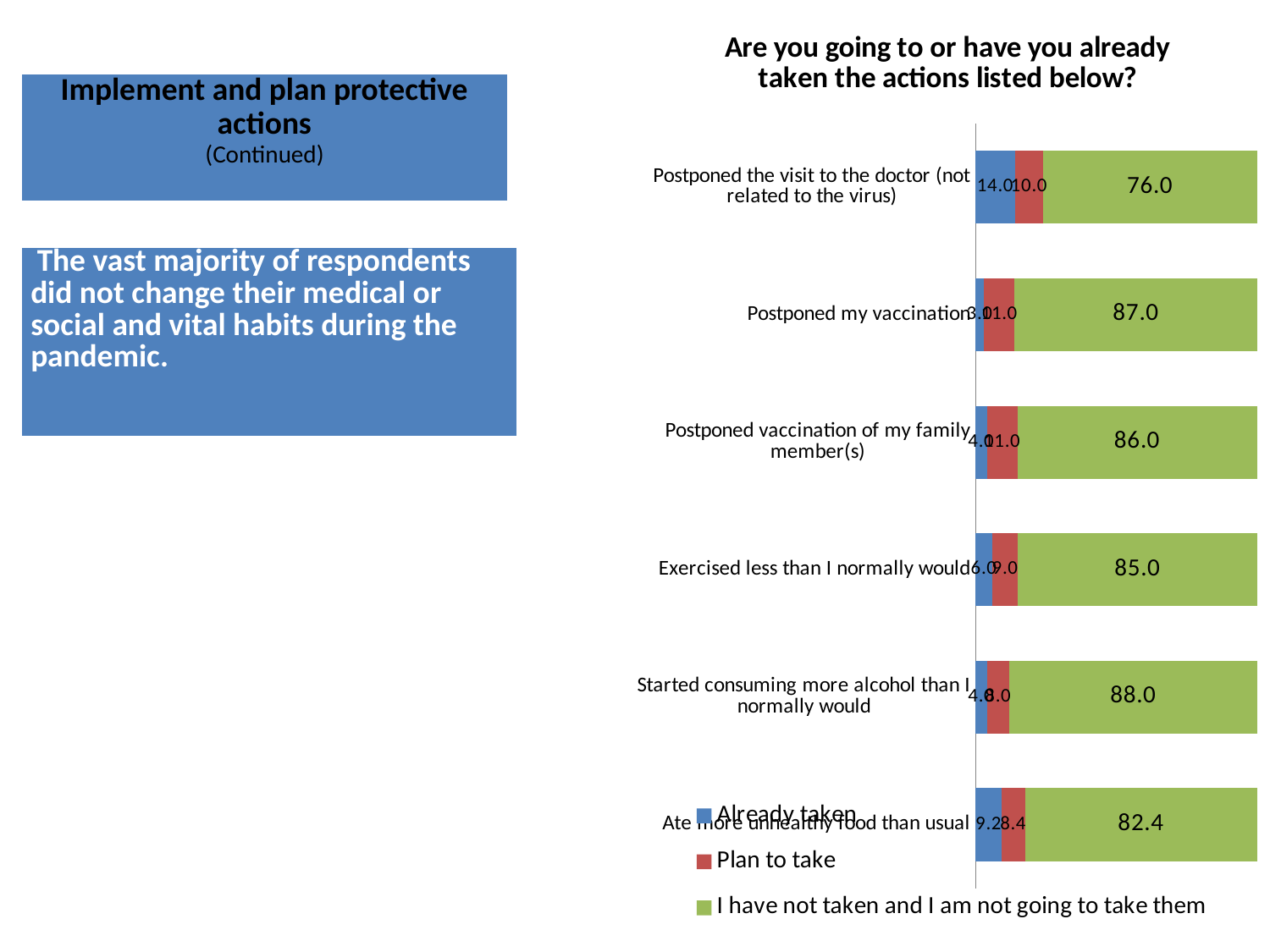
What kind of chart is shown on the slide? stacked bar chart What is the difference between the 'I have not taken and I am not going to take them' values for 'Started consuming more alcohol than I normally would' and 'Postponed the visit to the doctor (not related to the virus)'? 12.0 Which has a larger 'I have not taken and I am not going to take them' value: 'Postponed my vaccination' or 'Exercised less than I normally would'? Postponed my vaccination What is the value of 'I have not taken and I am not going to take them' for 'Ate more unhealthy food than usual'? 82.4 What is the value of 'I have not taken and I am not going to take them' for 'Started consuming more alcohol than I normally would'? 88.0 Which category has the highest value for 'I have not taken and I am not going to take them'? Started consuming more alcohol than I normally would What is the 'Already taken' value for 'Postponed the visit to the doctor (not related to the virus)'? 14.0 What is the title of the chart? Are you going to or have you already taken the actions listed below? How many series does the chart legend list? 3 How many action categories are plotted in the chart? 6 What is the value of 'I have not taken and I am not going to take them' for 'Postponed the visit to the doctor (not related to the virus)'? 76.0 Which category has the lowest value for 'I have not taken and I am not going to take them'? Postponed the visit to the doctor (not related to the virus)